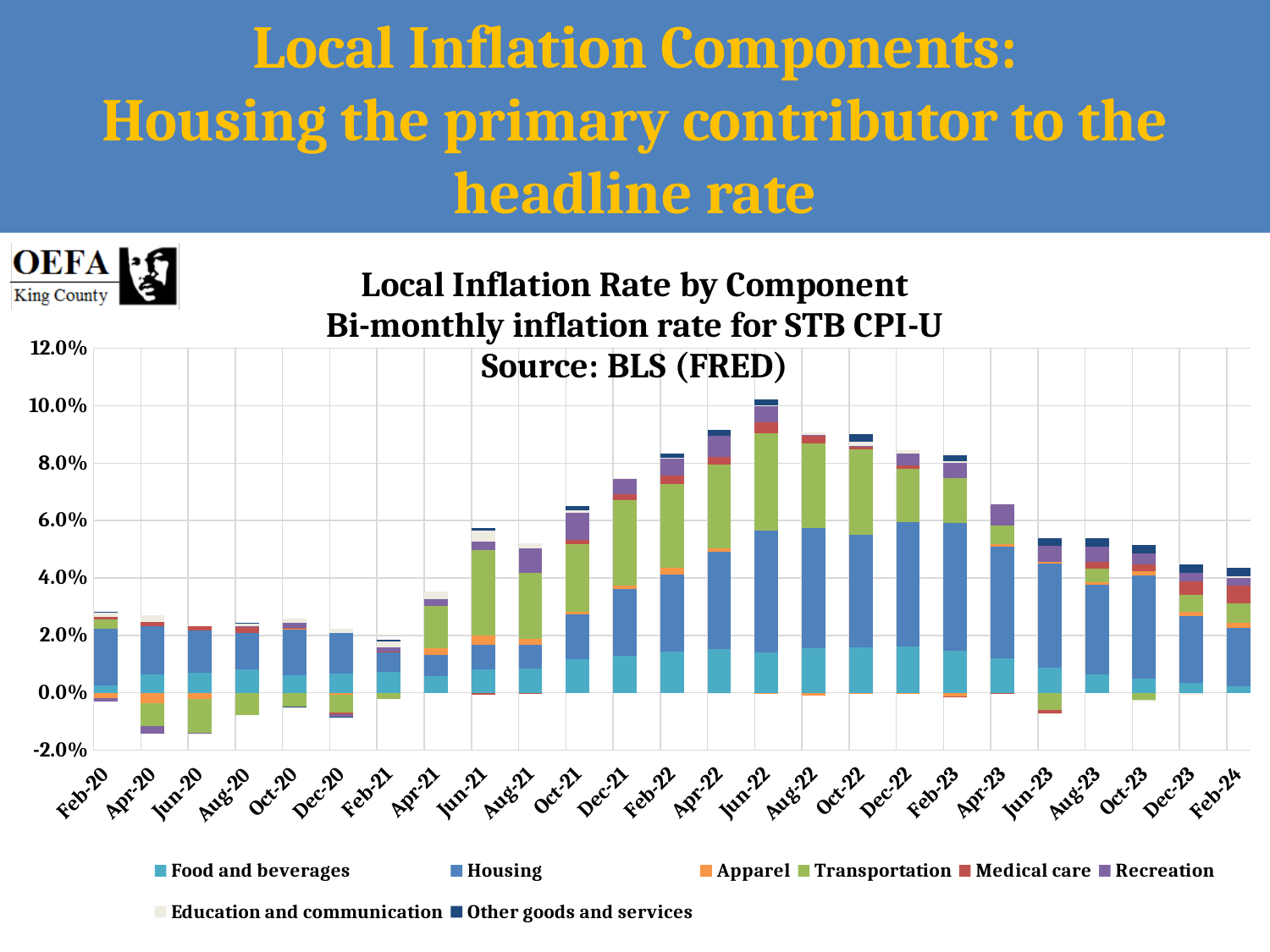
Is the total stacked value for Jun-22 greater or less than 8.0%? greater Which period has the tallest stacked bar (highest total inflation rate)? Jun-22 Is the total stacked value for Feb-24 greater or less than 6.0%? less How many series does the legend list? 8 What is the first line of the chart title? Local Inflation Rate by Component Which series is shown in the blue colour that makes up the largest part of most bars? Housing Is the total stacked value for Apr-23 greater or less than 6.0%? greater What kind of chart is shown on the slide? Stacked bar chart Which has the larger total stacked value, Jun-22 or Feb-24? Jun-22 Do the total stacked values generally rise or fall from Jun-22 to Feb-24? fall How many bi-monthly periods are plotted along the x axis? 25